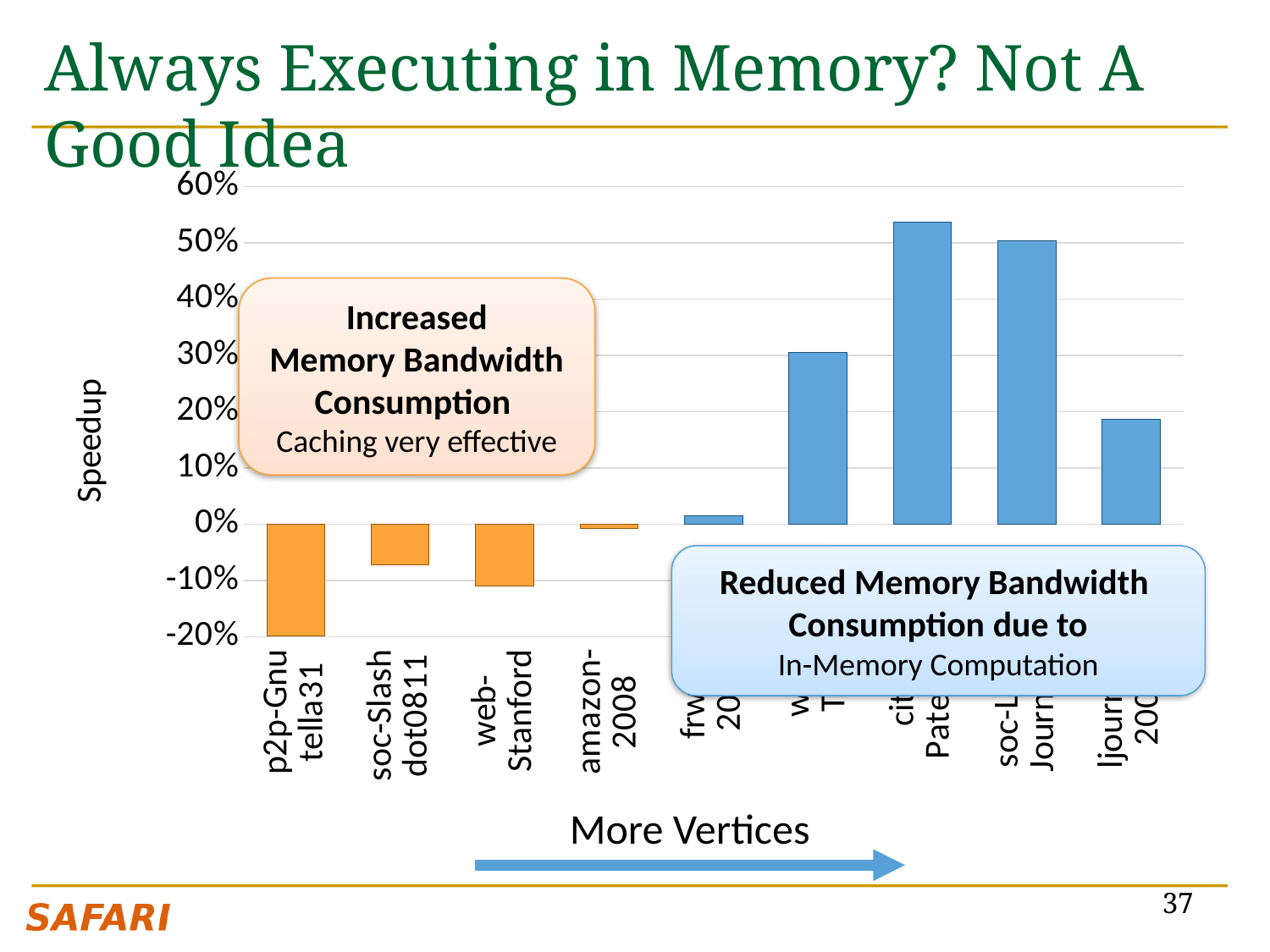
What is the label on the vertical axis of the chart? Speedup What kind of chart is shown on the slide? bar chart What does the arrow below the x axis indicate about the categories from left to right? More Vertices Is the speedup for soc-Slashdot0811 greater or less than -10%? greater Is the speedup for p2p-Gnutella31 greater or less than -10%? less Which has the larger speedup, soc-Slashdot0811 or web-Stanford? soc-Slashdot0811 Is the speedup for web-Stanford greater or less than 0%? less How many bars are plotted in the chart? 9 Which category has the lowest speedup in the chart? p2p-Gnutella31 Which has the larger speedup, p2p-Gnutella31 or amazon-2008? amazon-2008